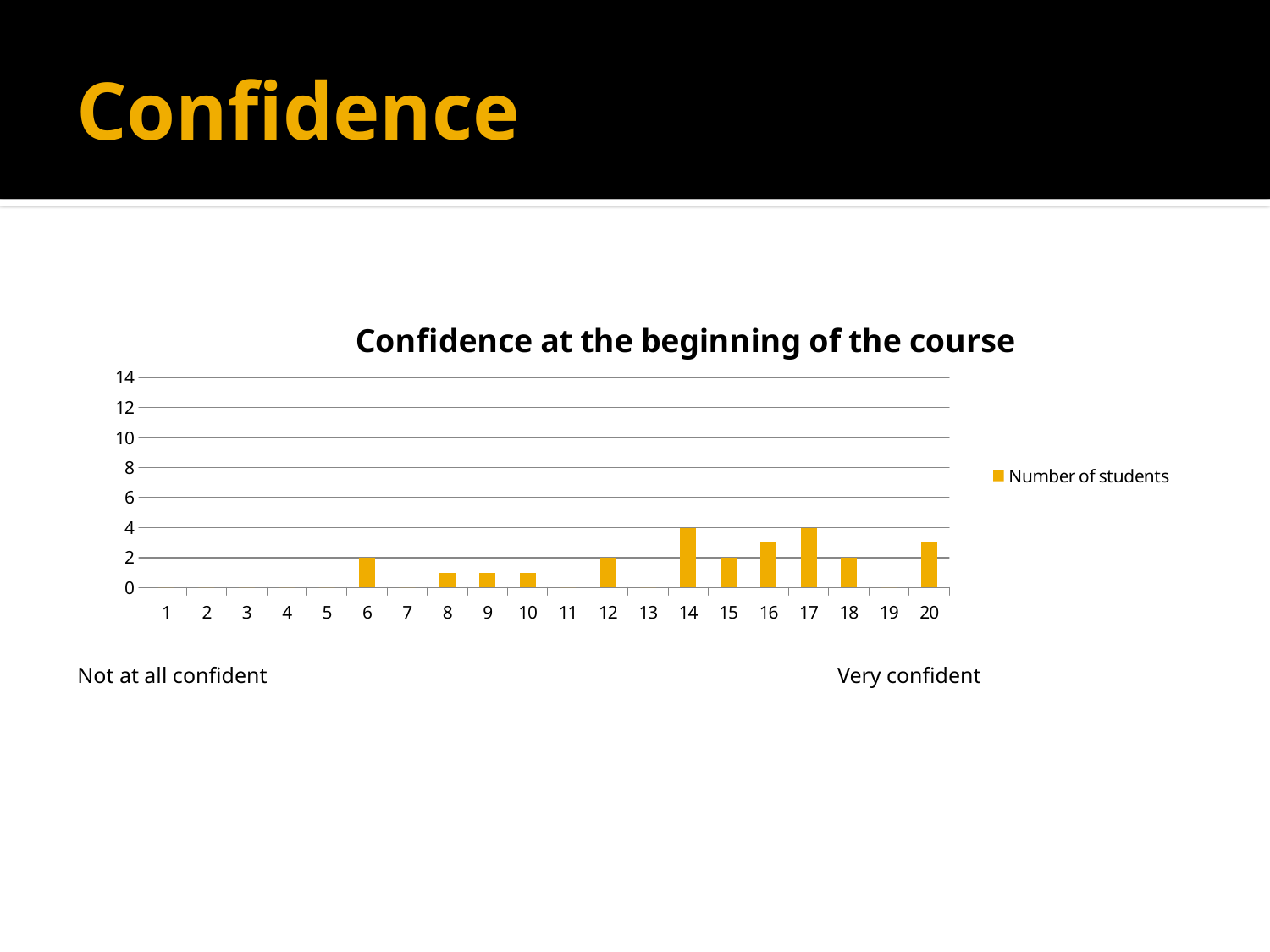
Is the value for category 8 greater or less than 2? less How many categories are shown on the x axis? 20 Which has more students, category 14 or category 15? 14 What type of chart is shown on the slide? bar chart Is the value for category 16 greater or less than 2? greater What is the title of the chart? Confidence at the beginning of the course What is the number of students for category 14? 4 What is the difference between the number of students for category 17 and category 12? 2 What is the number of students for category 18? 2 How many series does the legend list? 1 What is the number of students for category 6? 2 What is the name of the series shown in the legend? Number of students